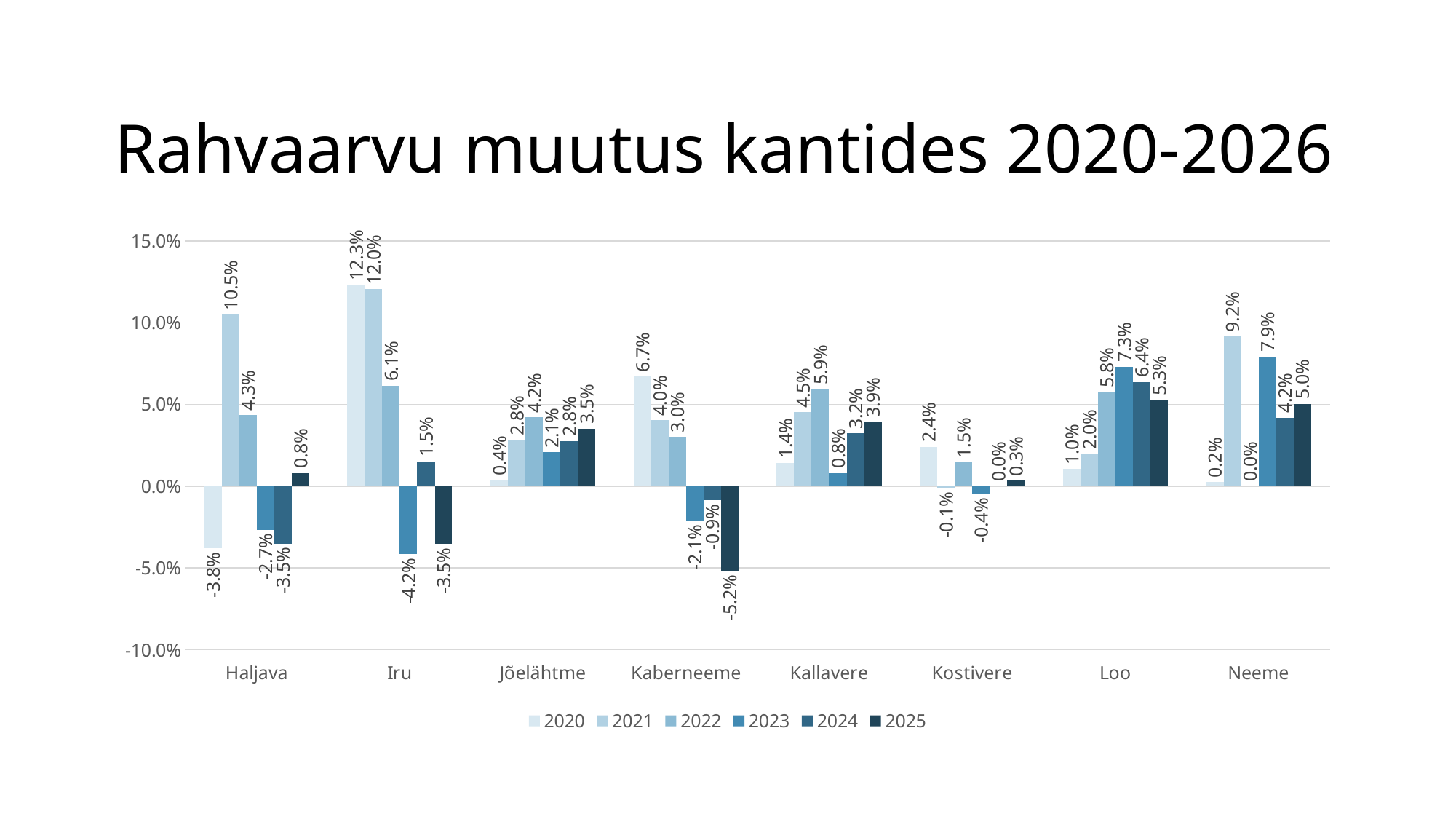
Which category has the highest value in the 2020 series? Iru How many categories are shown on the x axis? 8 Which category has the lowest value in the 2025 series? Kaberneeme How many series does the legend list? 6 What kind of chart is shown on the slide? Bar chart Which is larger for Kallavere: the 2022 value or the 2021 value? 2022 What is the value for Neeme in the 2022 series? 0.0% What is the difference between the 2020 and 2021 values for Iru? 0.3% What is the title of the chart? Rahvaarvu muutus kantides 2020-2026 What is the value for Kaberneeme in the 2025 series? -5.2% What is the value for Haljava in the 2021 series? 10.5% What is the value for Loo in the 2023 series? 7.3%